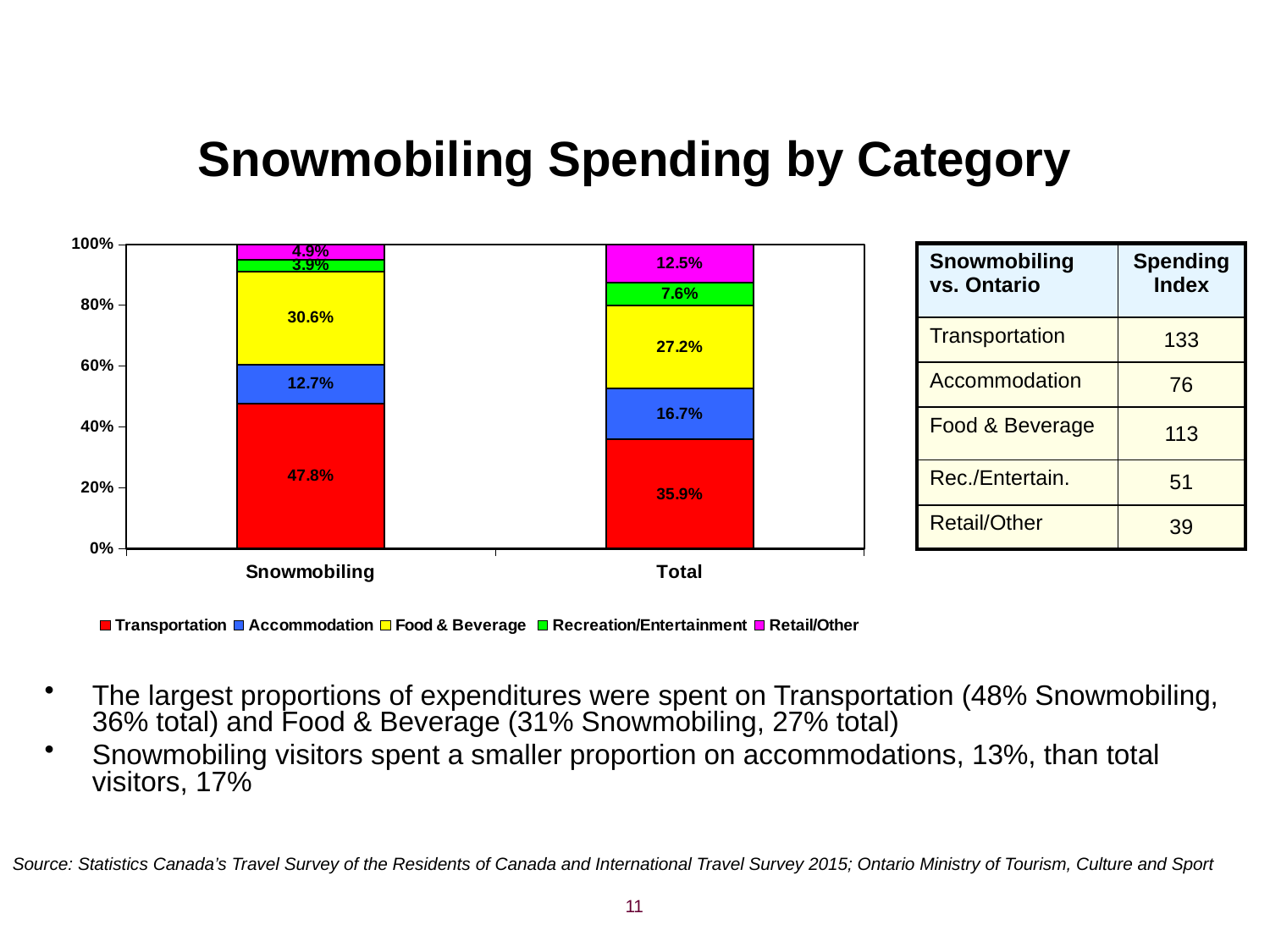
What is the difference in percentage points between the Accommodation share for Total and for Snowmobiling? 4.0 How many percentage points higher is the Transportation share for Snowmobiling than for Total? 11.9 Which spending category has the smallest share in the Total bar? Recreation/Entertainment How many series does the chart legend list? 5 What is the Accommodation share for the Total bar? 16.7% What percentage of Snowmobiling spending went to Transportation? 47.8% Which spending category has the largest share in the Snowmobiling bar? Transportation How many bars are shown on the x axis of the chart? 2 What type of chart is shown on the slide? Stacked bar chart What is the Food & Beverage share for the Total bar? 27.2% Which bar has the larger Recreation/Entertainment share, Snowmobiling or Total? Total What is the Retail/Other share for the Snowmobiling bar? 4.9%